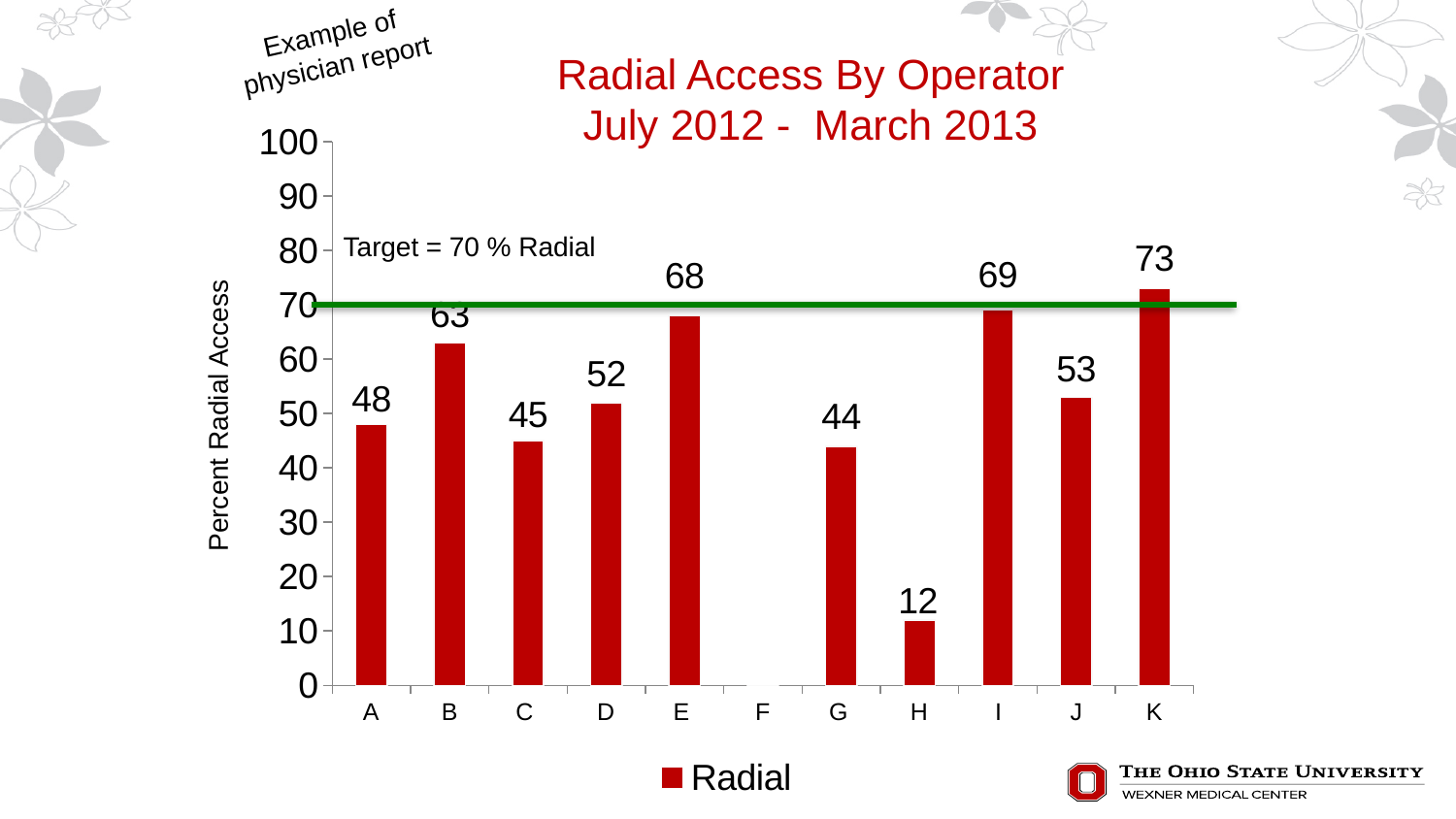
Is the value for operator I greater or less than 70? less Which operator has a larger value, B or D? B How many series does the legend list? 1 What is the difference between the values for operators K and H? 61 What kind of chart is shown on the slide? bar chart What target value is indicated by the horizontal line on the chart? 70 % Radial What is the value for operator K? 73 Which operator has the highest percent radial access? K What is the value for operator E? 68 How many operator categories are shown on the x axis? 11 What is the value for operator H? 12